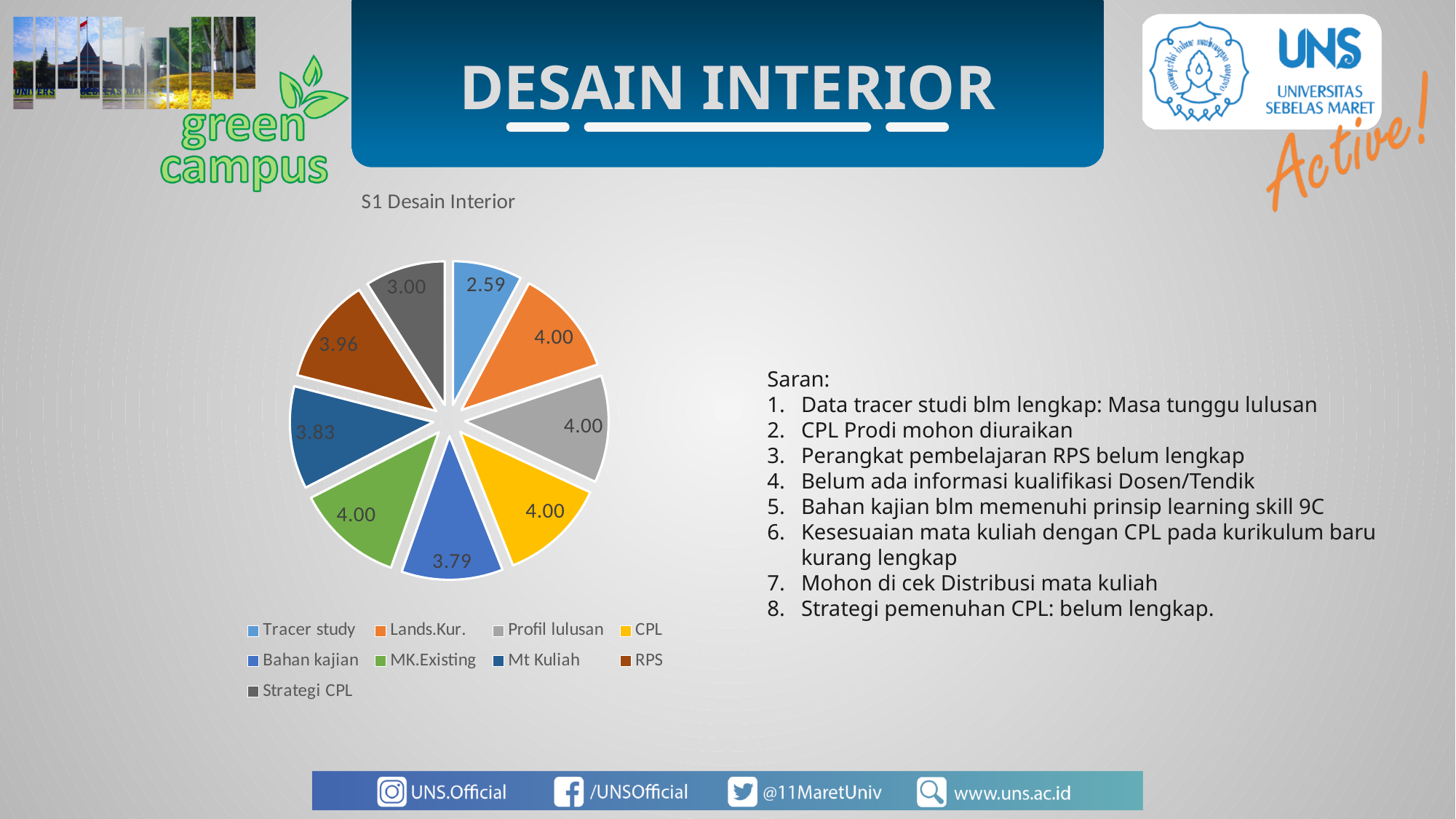
What is the difference between the value for Lands.Kur. and the value for Tracer study? 1.41 What is the value for Strategi CPL? 3.00 How many categories does the pie chart have? 9 What is the value for Bahan kajian? 3.79 What is the value for Tracer study? 2.59 What is the value for RPS? 3.96 What colour is the slice for CPL? yellow Which is larger, the value for RPS or the value for Mt Kuliah? RPS What is the value for Mt Kuliah? 3.83 Which category has the lowest value? Tracer study What is the title of the chart? S1 Desain Interior What type of chart is shown on the slide? pie chart